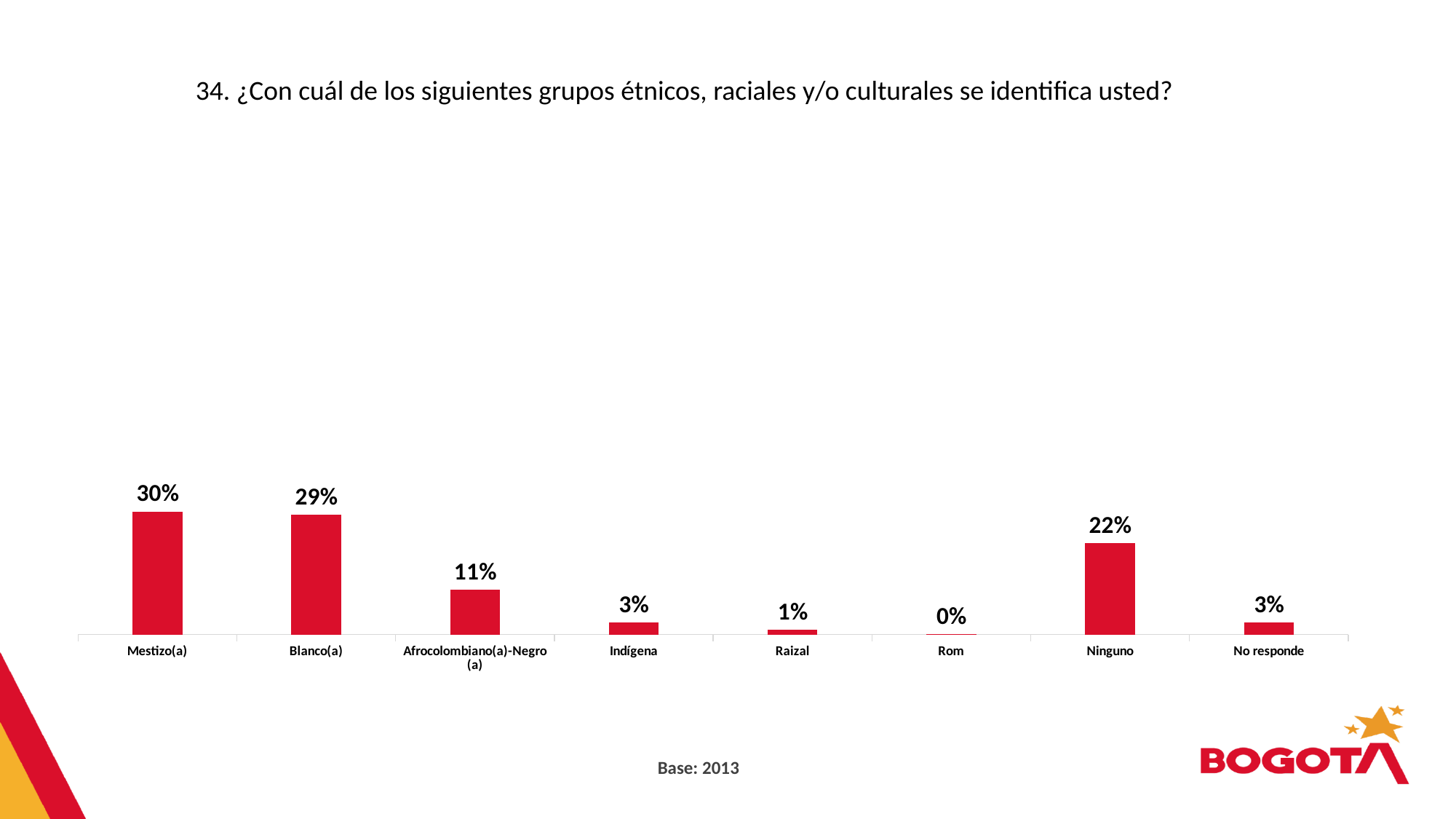
What is the difference between the values for Blanco(a) and Ninguno? 7% Which category has the lowest value? Rom Which category has the highest value? Mestizo(a) How many categories are shown on the x axis? 8 What is the difference between the values for Mestizo(a) and Blanco(a)? 1% Which is larger, the value for Indígena or the value for Raizal? Indígena What is the value for Rom? 0% What kind of chart is shown on the slide? Bar chart What percentage of respondents identified as Mestizo(a)? 30% What percentage is shown for Afrocolombiano(a)-Negro(a)? 11% What is the value shown for Ninguno? 22% What base (number of respondents) is stated below the chart? 2013